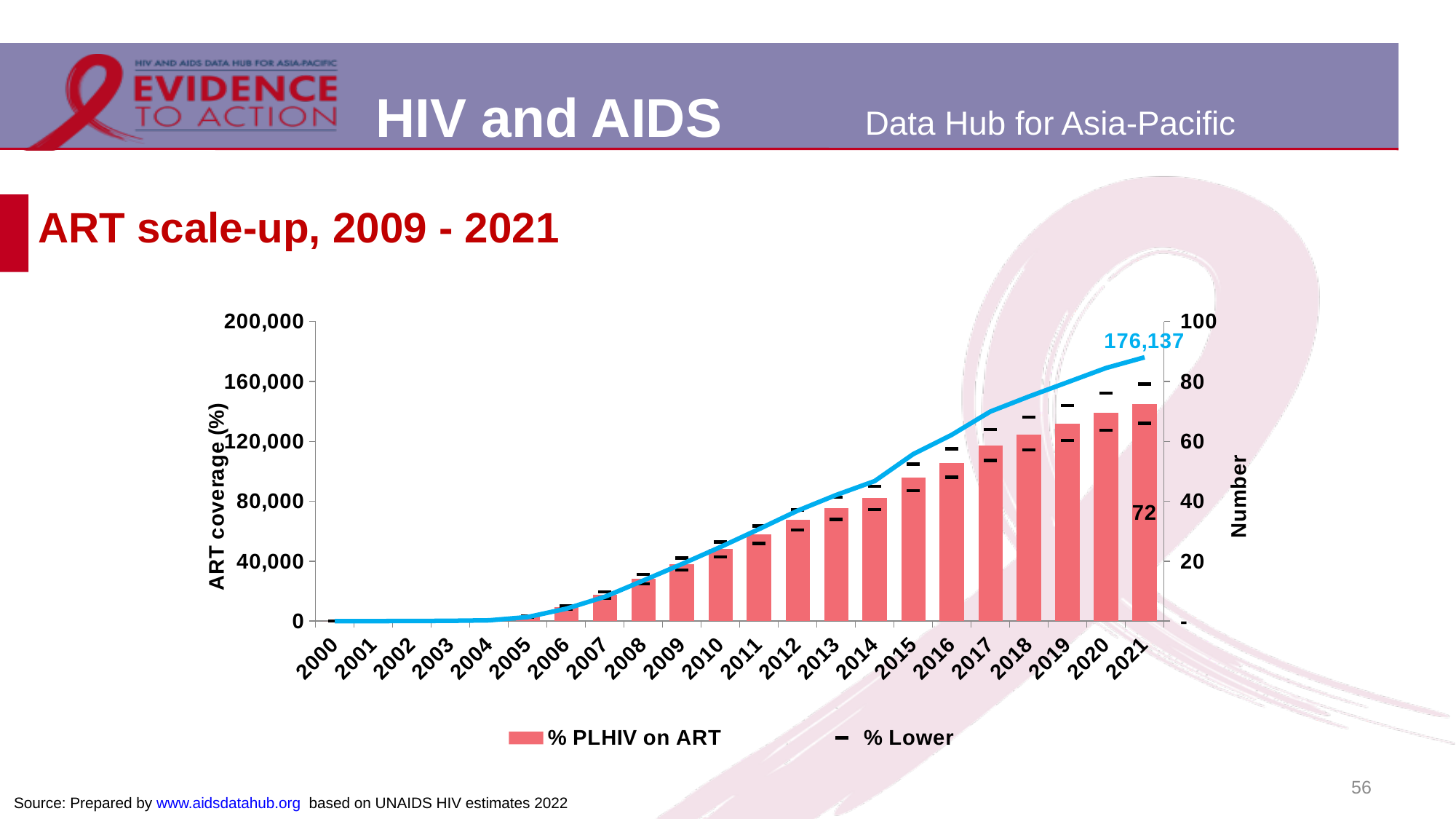
How many years are shown on the x axis? 22 How many series does the legend list? 2 What is the % PLHIV on ART value labelled on the bar for 2021? 72 Do the % PLHIV on ART bars generally rise or fall from 2005 to 2021? rise Is the blue line value for 2017 greater or less than 120,000 on the left axis? greater Is the % PLHIV on ART bar for 2005 greater or less than 20 on the right axis? less What is the title of the chart? ART scale-up, 2009 - 2021 Is the % PLHIV on ART bar for 2015 greater or less than 40 on the right axis? greater Which year has the larger % PLHIV on ART bar, 2010 or 2021? 2021 What is the data label shown on the blue line for 2021? 176,137 What kind of chart is shown on the slide? Combined bar and line chart Which year has the tallest % PLHIV on ART bar? 2021